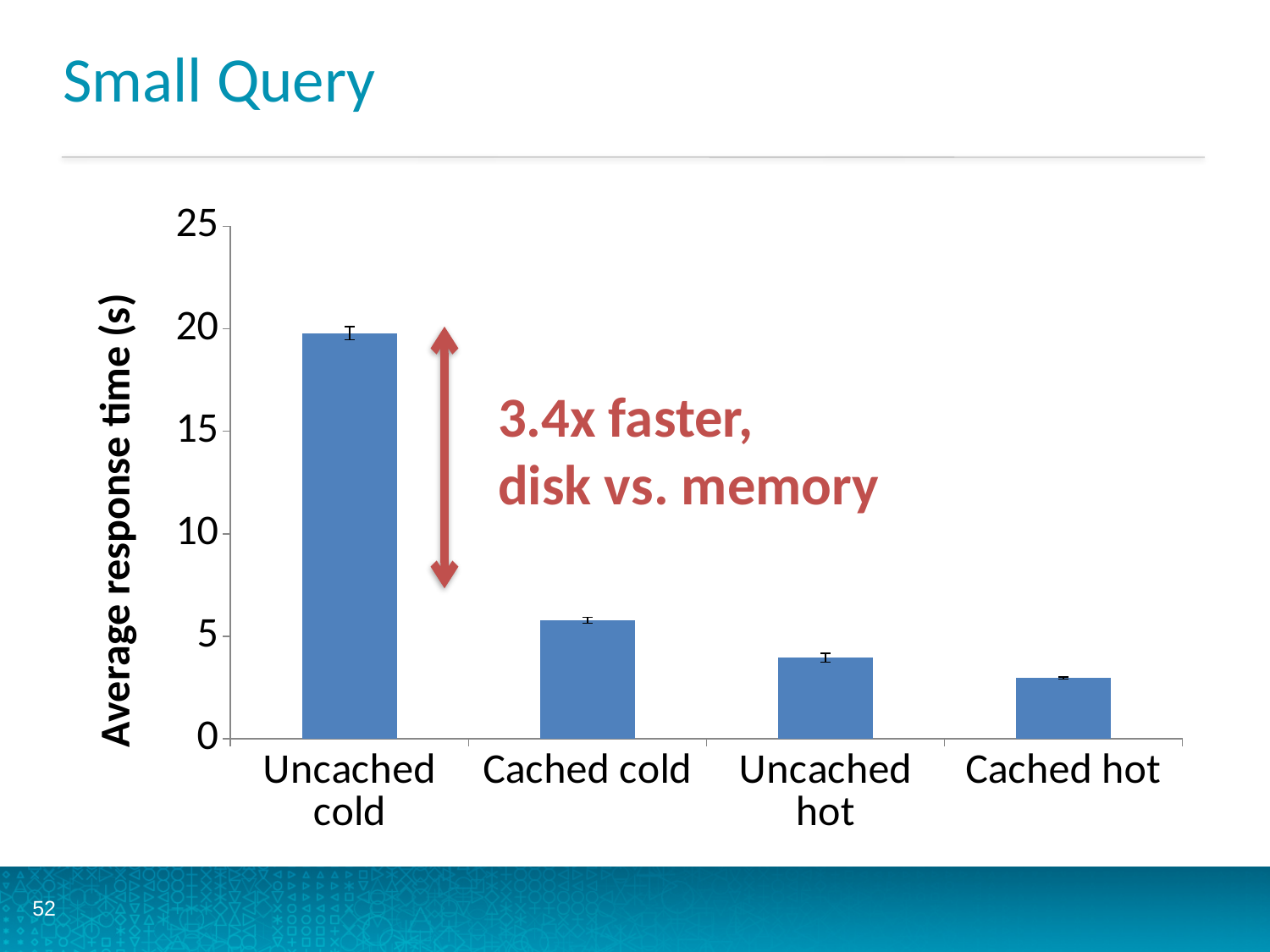
How many categories are shown on the x axis of the chart? 4 What speed-up does the red annotation on the chart state for disk vs. memory? 3.4x faster Is the value for Cached hot greater or less than 5? less Which category has the highest average response time? Uncached cold Is the value for Uncached hot greater or less than 5? less Which has a larger average response time, Cached cold or Uncached hot? Cached cold Which category has the lowest average response time? Cached hot Is the value for Uncached cold greater or less than 15? greater Do the bar values rise or fall from left to right along the x axis? fall What kind of chart is shown on the slide? bar chart What is the label of the y axis? Average response time (s)